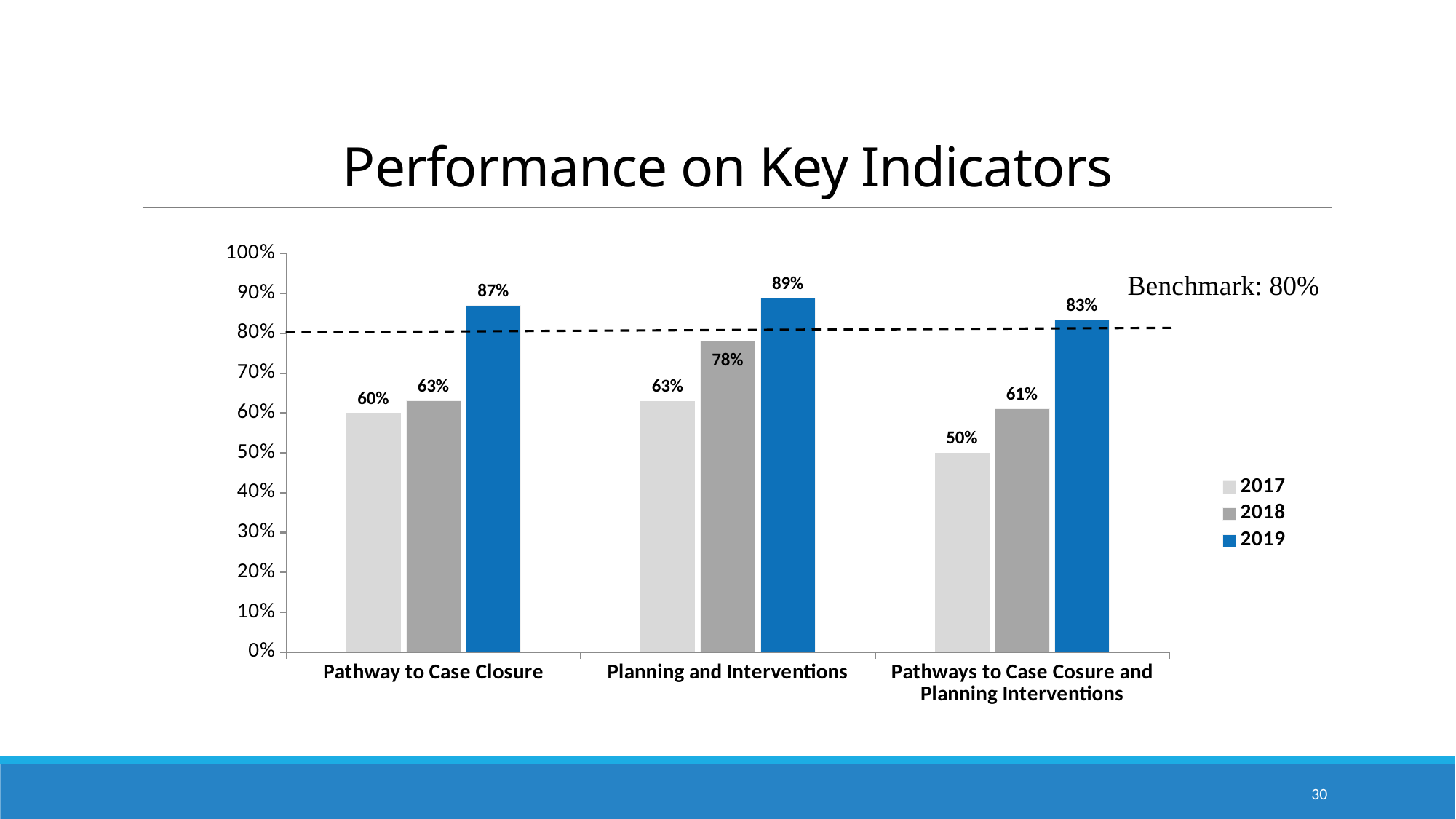
What is the difference between the 2019 and 2017 values for Planning and Interventions? 26% Which category has the lowest 2017 value? Pathways to Case Cosure and Planning Interventions How many categories are shown on the x axis? 3 How many series does the legend list? 3 What benchmark value is marked by the dashed line on the chart? 80% What is the 2019 value for Pathway to Case Closure? 87% What is the 2017 value for Pathways to Case Cosure and Planning Interventions? 50% Which is larger: the 2018 value for Pathway to Case Closure or the 2018 value for Planning and Interventions? Planning and Interventions What kind of chart is shown on the slide? Bar chart Do the values for Pathway to Case Closure rise or fall from 2017 to 2019? Rise Which category has the highest 2019 value? Planning and Interventions What is the 2018 value for Planning and Interventions? 78%